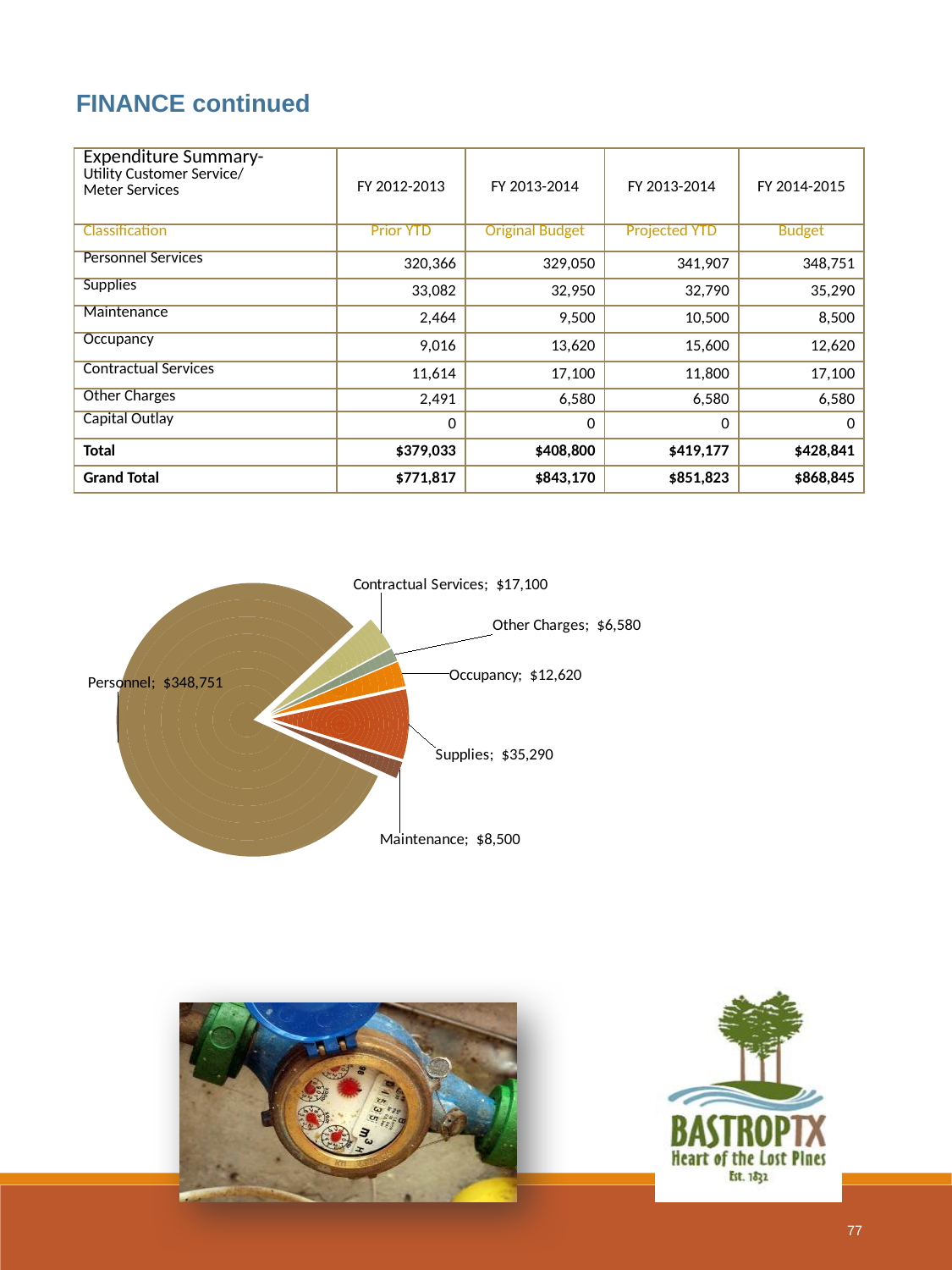
Which category has the largest slice in the pie chart? Personnel How many slices does the pie chart have? 6 What kind of chart is shown on the slide? Pie chart What is the difference between the Supplies and Contractual Services values in the pie chart? $18,190 What is the total of all the slice values in the pie chart? $428,841 What is the value shown for Maintenance in the pie chart? $8,500 In the pie chart, which is larger: Occupancy or Other Charges? Occupancy What is the value shown for Contractual Services in the pie chart? $17,100 Which category has the smallest slice in the pie chart? Other Charges What is the difference between the Occupancy and Maintenance values in the pie chart? $4,120 What is the value shown for Personnel in the pie chart? $348,751 What is the value shown for Supplies in the pie chart? $35,290